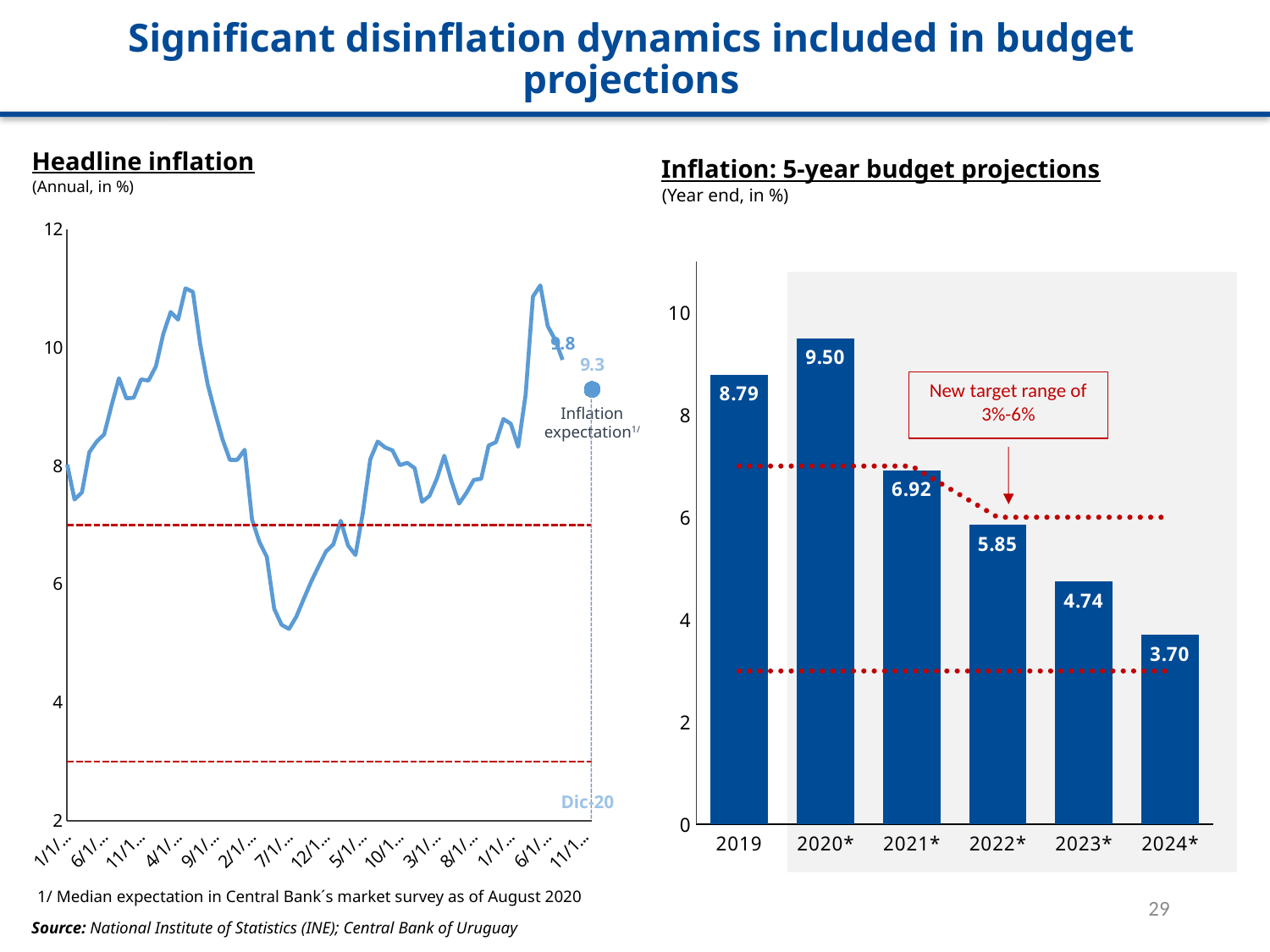
In the 'Inflation: 5-year budget projections' chart, which is larger, the value for 2022* or the value for 2023*? 2022* In the 'Inflation: 5-year budget projections' chart, do the values rise or fall from 2020* to 2024*? Fall In the 'Inflation: 5-year budget projections' chart, which year has the lowest value? 2024* In the 'Inflation: 5-year budget projections' chart, what is the difference between the 2020* and 2021* values? 2.58 In the 'Headline inflation' chart, what is the value of the inflation expectation point labelled for Dic-20? 9.3 In the 'Inflation: 5-year budget projections' chart, which year has the highest value? 2020* In the 'Inflation: 5-year budget projections' chart, how many years are shown on the x axis? 6 In the 'Inflation: 5-year budget projections' chart, what is the value for 2019? 8.79 In the 'Inflation: 5-year budget projections' chart, what is the projected value for 2021*? 6.92 What kind of chart is 'Headline inflation'? Line chart In the 'Inflation: 5-year budget projections' chart, what is the projected value for 2024*? 3.70 What kind of chart is 'Inflation: 5-year budget projections'? Bar chart